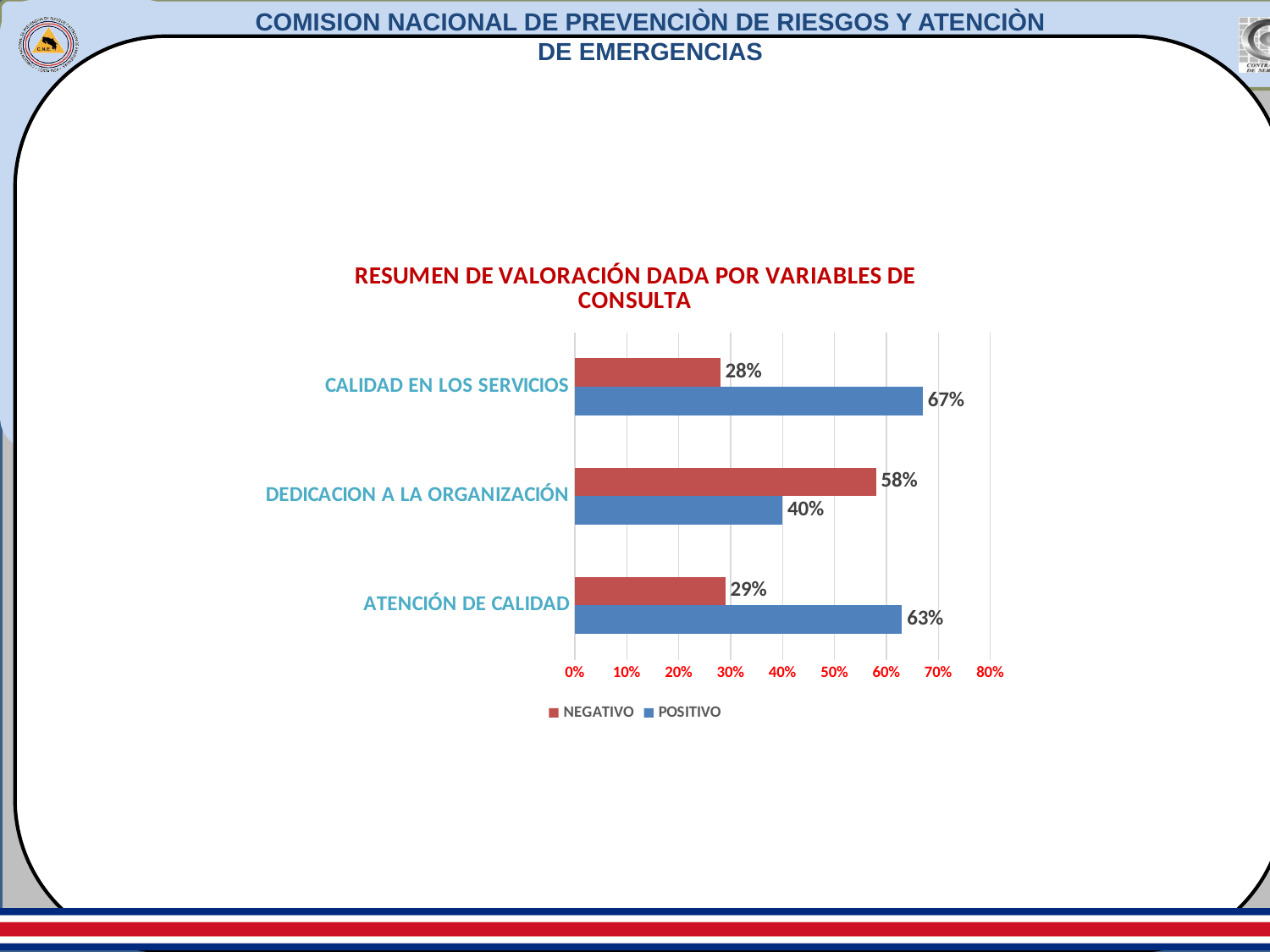
Which category has the lowest NEGATIVO value? CALIDAD EN LOS SERVICIOS What is the POSITIVO value for CALIDAD EN LOS SERVICIOS? 67% What kind of chart is shown on the slide? Bar chart What is the difference between the POSITIVO and NEGATIVO values for DEDICACION A LA ORGANIZACIÓN? 18% Which is larger for ATENCIÓN DE CALIDAD, the POSITIVO or the NEGATIVO value? POSITIVO What is the NEGATIVO value for ATENCIÓN DE CALIDAD? 29% What is the NEGATIVO value for DEDICACION A LA ORGANIZACIÓN? 58% What is the POSITIVO value for ATENCIÓN DE CALIDAD? 63% Which category has the highest POSITIVO value? CALIDAD EN LOS SERVICIOS What is the title of the chart? RESUMEN DE VALORACIÓN DADA POR VARIABLES DE CONSULTA How many series does the legend list? 2 How many categories are shown on the chart? 3